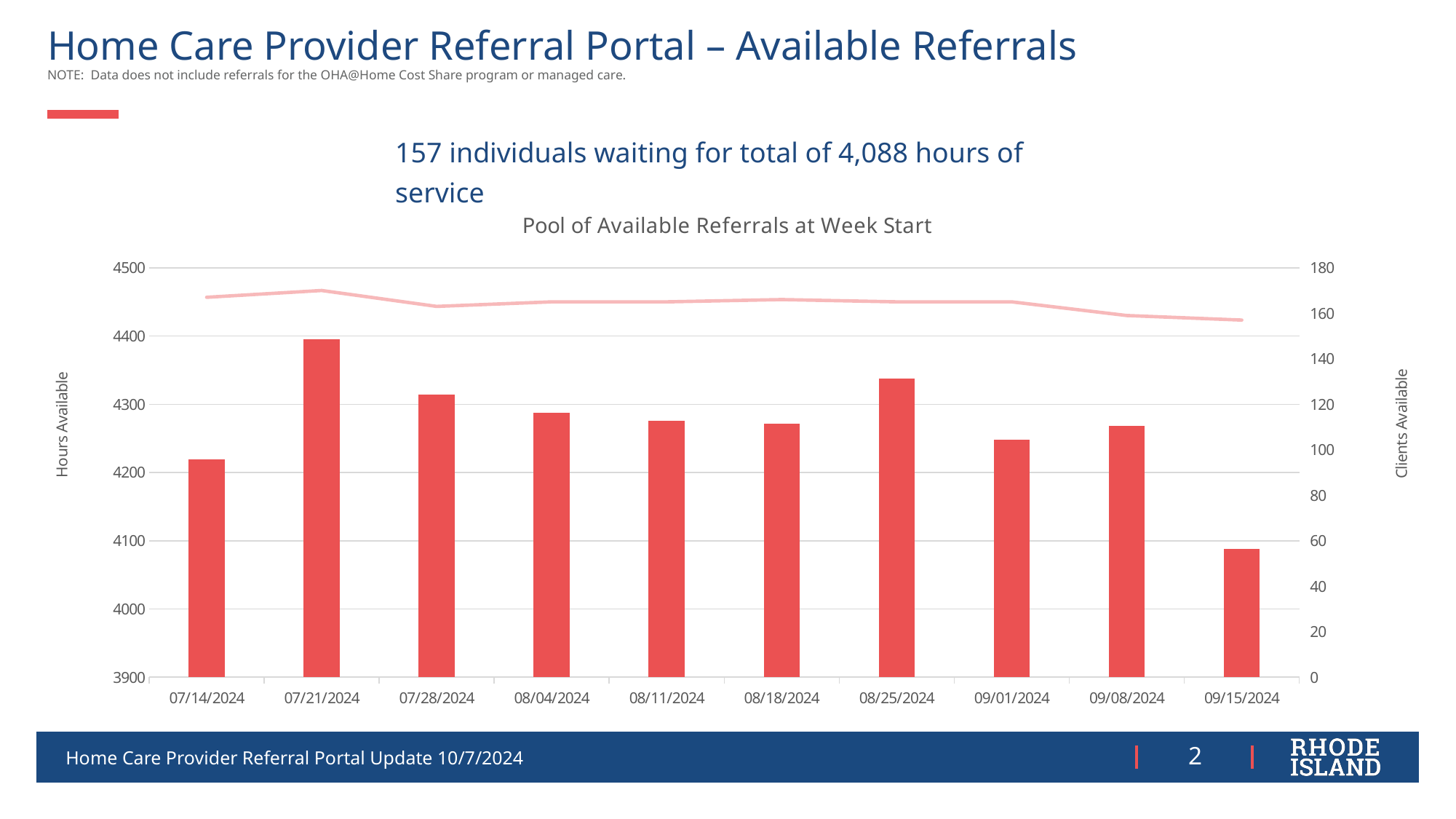
Is the Clients Available line value for 09/15/2024 greater or less than 140? greater Is the Hours Available bar for 07/21/2024 greater or less than 4300? greater Is the Hours Available bar for 09/15/2024 greater or less than 4100? less Does the Clients Available line rise or fall from 08/25/2024 to 09/15/2024? fall Which week start has the shortest bar for Hours Available? 09/15/2024 What is the title of the chart on the slide? Pool of Available Referrals at Week Start What kind of chart is shown on the slide? A bar chart combined with a line Which has the larger Hours Available bar, 08/25/2024 or 09/01/2024? 08/25/2024 What is the label on the right-hand vertical axis of the chart? Clients Available Which week start has the tallest bar for Hours Available? 07/21/2024 How many week-start dates are shown on the x axis of the chart? 10